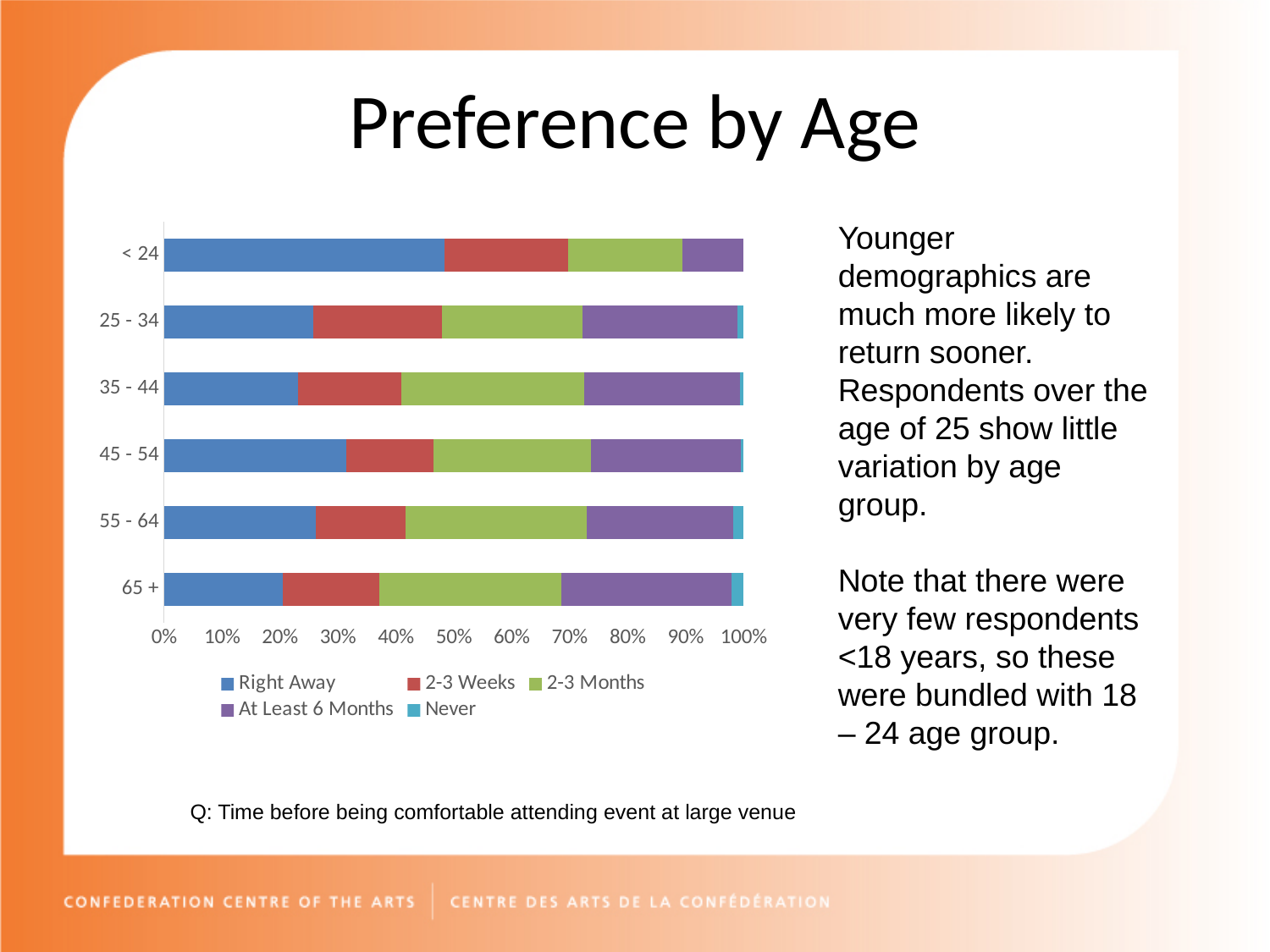
Which age group has the largest "Right Away" segment? < 24 Which series is shown in blue in the legend? Right Away Is the "Right Away" value for the < 24 age group greater or less than 40%? greater Which age group has the smallest "At Least 6 Months" segment? < 24 How many series does the legend list? 5 Is the "Right Away" value for the 65 + age group greater or less than 30%? less Is the "Right Away" value for the 45 - 54 age group greater or less than 40%? less Which is larger, the "At Least 6 Months" segment for 65 + or for < 24? 65 + Which is larger, the "Right Away" segment for < 24 or for 35 - 44? < 24 What kind of chart is shown on the slide? Stacked bar chart What is the title of the chart? Preference by Age How many age groups are shown on the chart? 6